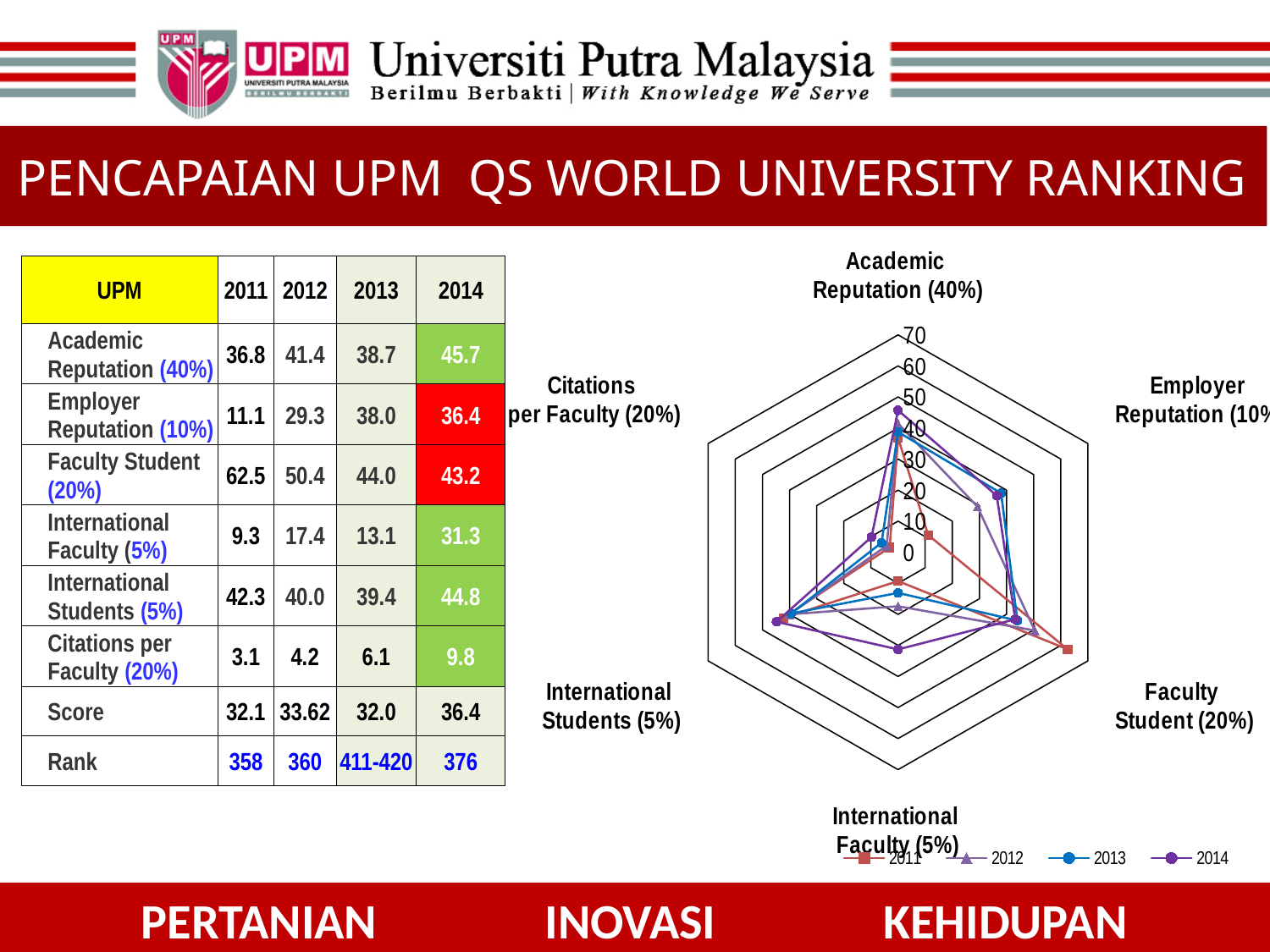
How many categories (axes) does the radar chart have? 6 What kind of chart is shown on the right of the slide? Radar chart Which category has the highest value for the 2011 series? Faculty Student (20%) What are the series names listed in the legend of the radar chart? 2011, 2012, 2013, 2014 What is the highest tick value shown on the radar chart's axis? 70 How many series does the legend of the radar chart list? 4 In the radar chart, is the 2014 value for Citations per Faculty (20%) greater or less than 20? less What is the difference between the 2013 and 2011 values for Employer Reputation (10%)? 26.9 For International Faculty (5%), which series has the larger value, 2011 or 2014? 2014 Which category has the lowest value for the 2011 series? Citations per Faculty (20%) In the radar chart, is the 2011 value for Faculty Student (20%) greater or less than 50? greater What is the 2014 value for Academic Reputation (40%)? 45.7